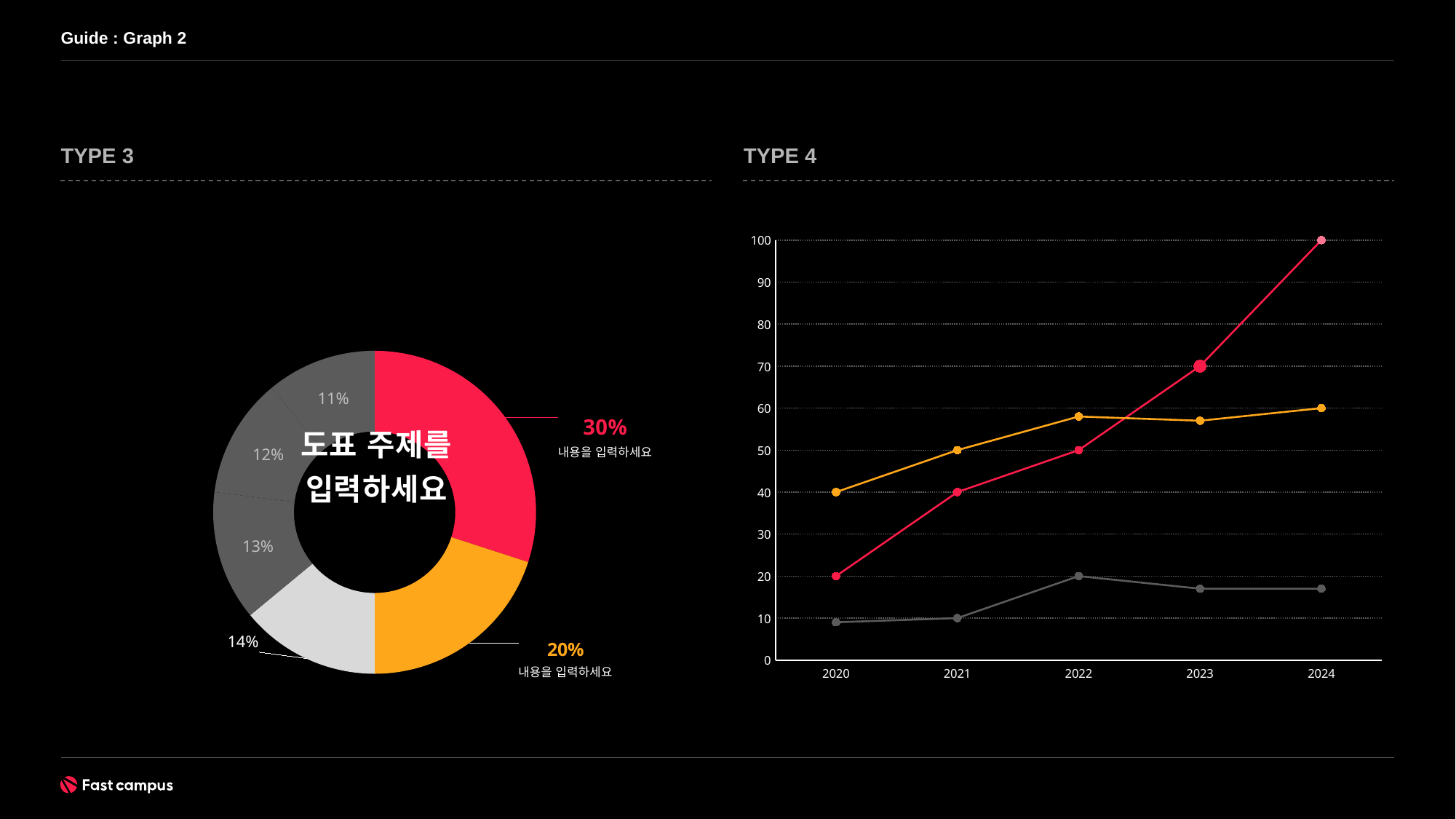
In the TYPE 3 pie chart, what is the percentage of the smallest slice? 11% In the TYPE 4 line chart, what is the value of the red line in 2020? 20 In the TYPE 4 line chart, what is the value of the orange line in 2021? 50 In the TYPE 4 line chart, what is the value of the red line in 2024? 100 How many slices does the TYPE 3 pie chart have? 6 What type of chart is shown under TYPE 4 on the right of the slide? line chart In the TYPE 4 line chart, is the value of the gray line in 2023 greater or less than 20? less In the TYPE 4 line chart, how many lines are plotted? 3 In the TYPE 3 pie chart, what is the percentage of the largest slice? 30% In the TYPE 3 pie chart, what is the difference between the red slice (30%) and the orange slice (20%)? 10% What type of chart is shown under TYPE 3 on the left of the slide? pie chart (donut) In the TYPE 4 line chart, does the red line rise or fall from 2020 to 2024? rise